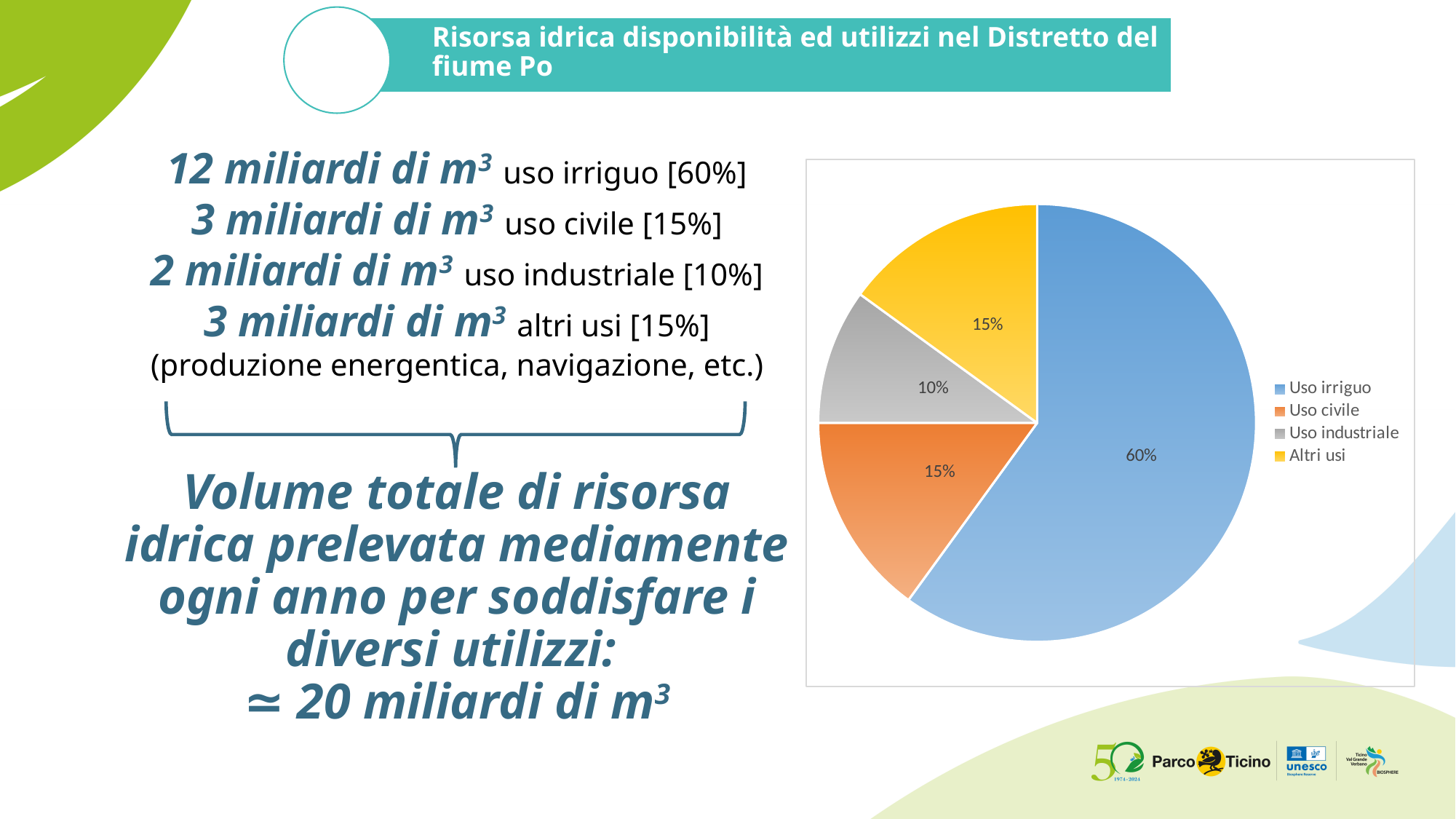
What share of the pie does Uso industriale represent? 10% What share of the pie does Uso irriguo represent? 60% Which category has the smallest slice of the pie? Uso industriale How many slices does the pie chart have? 4 What colour is the slice for Altri usi? yellow What share of the pie does Uso civile represent? 15% How many entries does the legend list? 4 Which is larger, the slice for Uso civile or the slice for Uso industriale? Uso civile What kind of chart is shown on the slide? pie chart What is the difference in percentage points between Uso irriguo and Uso civile? 45 Which category has the largest slice of the pie? Uso irriguo